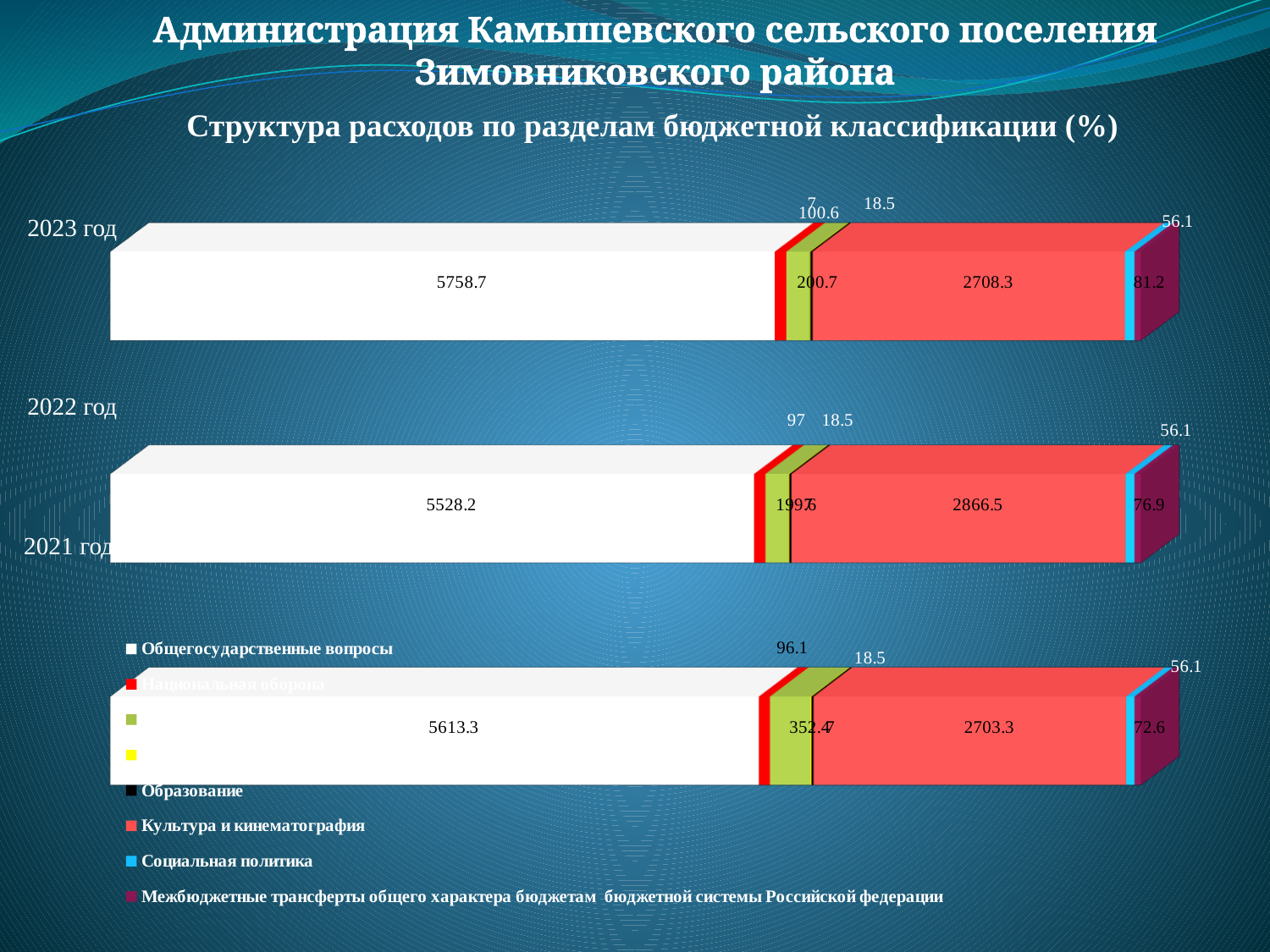
Which is larger: Общегосударственные вопросы in 2021 or in 2022? 2021 What is the value for Межбюджетные трансферты общего характера in 2023? 56.1 Does the value for Социальная политика rise or fall from 2021 to 2023? Rises How many years (bars) are shown in the chart? 3 What is the value for Социальная политика in 2022? 76.9 In which year is the value for Культура и кинематография the highest? 2022 What is the value for Общегосударственные вопросы in 2022? 5528.2 What is the value for Культура и кинематография in 2021? 2703.3 In which year is the value for Общегосударственные вопросы the highest? 2023 What type of chart is shown on the slide? Stacked bar chart What is the value for Общегосударственные вопросы in 2023? 5758.7 What is the difference between the Социальная политика values for 2023 and 2021? 8.6